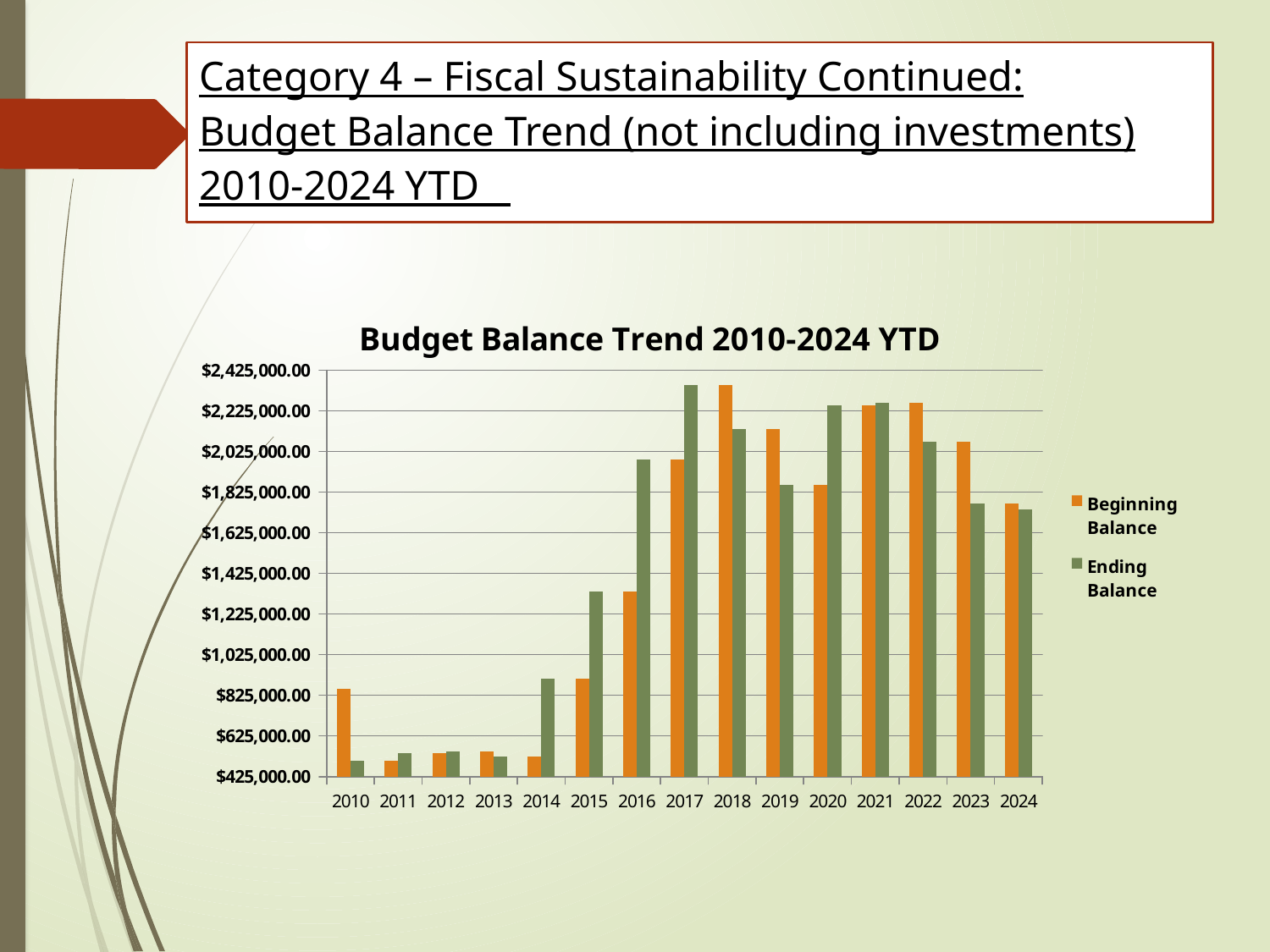
Does the Beginning Balance rise or fall from 2021 to 2024? Fall Which colour represents the Beginning Balance series? Orange Is the Ending Balance for 2015 greater or less than $1,225,000.00? greater Is the Beginning Balance for 2024 greater or less than $1,825,000.00? less How many years are shown on the x axis of the chart? 15 Is the Ending Balance for 2017 greater or less than $2,225,000.00? greater How many series does the chart legend list? 2 What type of chart is shown on the slide? Bar chart In 2018, which is larger: the Beginning Balance or the Ending Balance? Beginning Balance What is the title of the chart? Budget Balance Trend 2010-2024 YTD In which year is the Ending Balance highest? 2017 In which year is the Beginning Balance highest? 2018